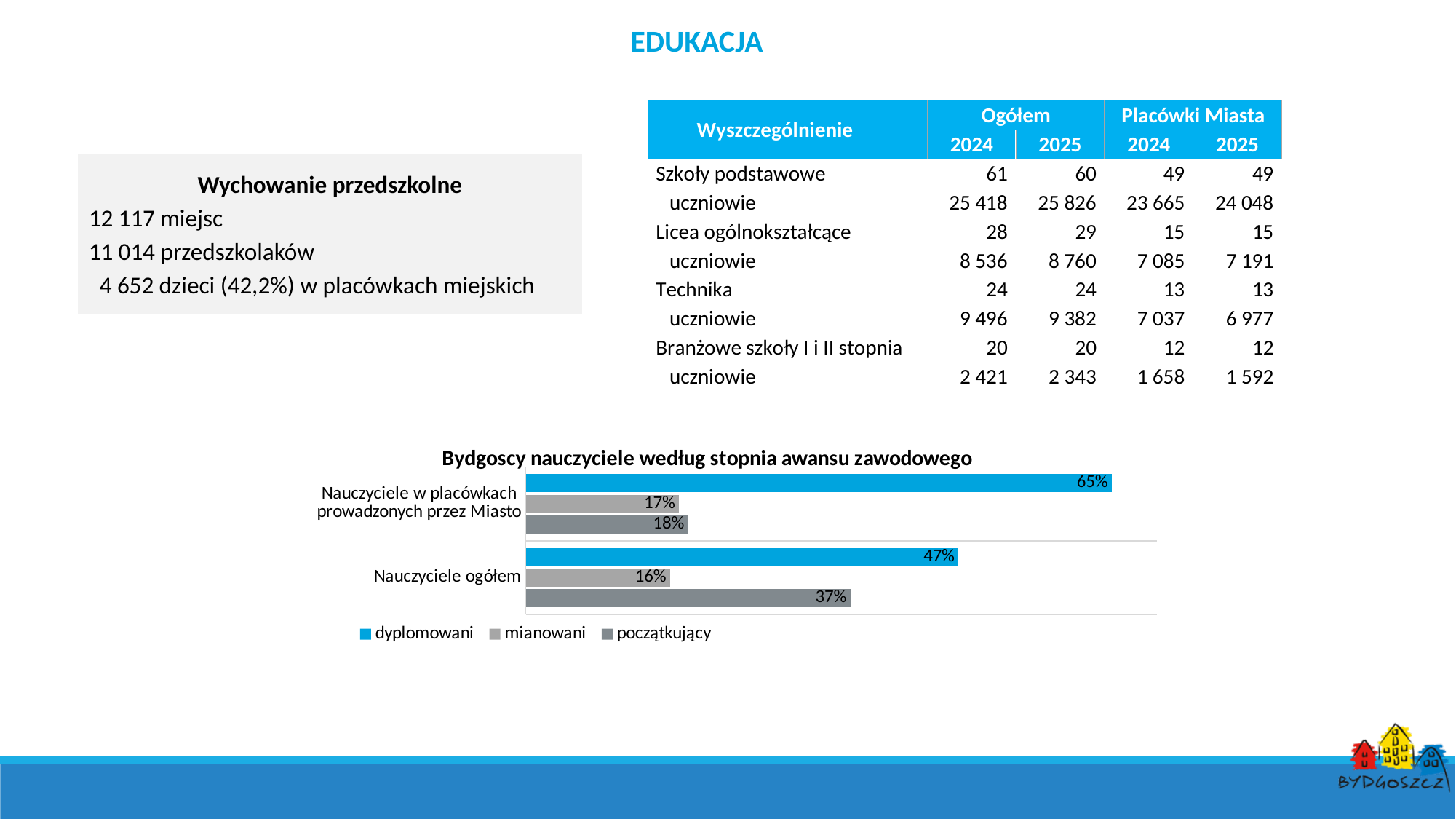
In the chart, what is the value for 'mianowani' among 'Nauczyciele ogółem'? 16% In the chart, which is larger: 'początkujący' for 'Nauczyciele ogółem' or 'początkujący' for 'Nauczyciele w placówkach prowadzonych przez Miasto'? Nauczyciele ogółem In the chart, what is the value for 'początkujący' among 'Nauczyciele w placówkach prowadzonych przez Miasto'? 18% In the chart, what is the value for 'dyplomowani' among 'Nauczyciele w placówkach prowadzonych przez Miasto'? 65% How many series does the chart's legend list? 3 In the chart, which series has the lowest value for 'Nauczyciele w placówkach prowadzonych przez Miasto'? mianowani What colour are the 'dyplomowani' bars in the chart? blue In the chart, which series has the highest value for 'Nauczyciele ogółem'? dyplomowani How many categories are shown on the chart's vertical axis? 2 What kind of chart is 'Bydgoscy nauczyciele według stopnia awansu zawodowego'? bar chart In the chart, what is the value for 'początkujący' among 'Nauczyciele ogółem'? 37% In the chart, what is the difference between the 'dyplomowani' values for 'Nauczyciele w placówkach prowadzonych przez Miasto' and 'Nauczyciele ogółem'? 18%